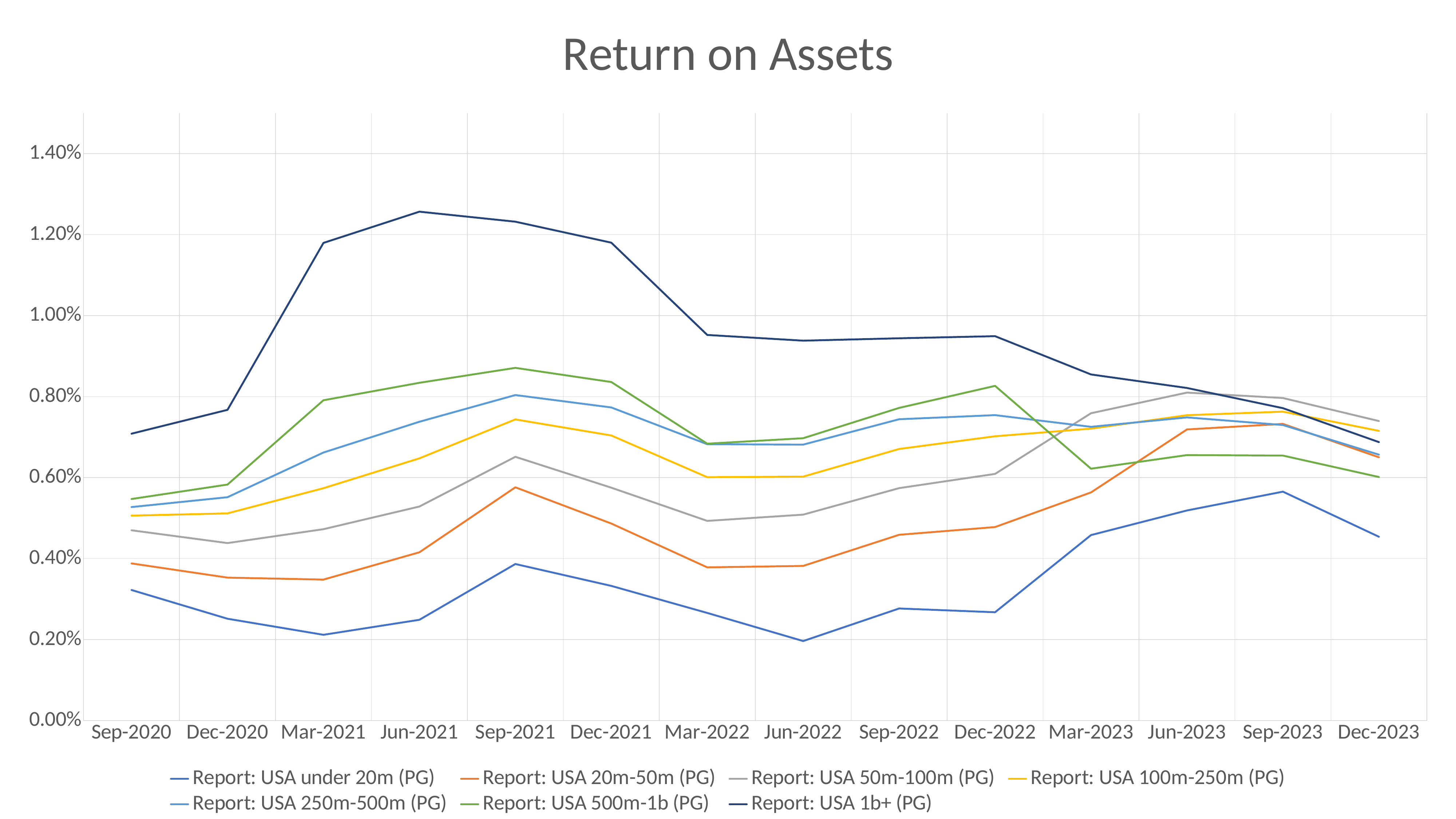
Is the value for Report: USA 50m-100m (PG) at Sep-2020 greater or less than 0.60%? less Is the value for Report: USA under 20m (PG) at Jun-2022 greater or less than 0.40%? less Which series has the highest value at Jun-2021? Report: USA 1b+ (PG) Which series has the highest value at Sep-2020? Report: USA 1b+ (PG) Which series has the lowest value at Jun-2022? Report: USA under 20m (PG) At Sep-2021, which is larger: Report: USA 500m-1b (PG) or Report: USA 20m-50m (PG)? Report: USA 500m-1b (PG) What is the title of the chart? Return on Assets What type of chart is shown on the slide? line chart How many series does the legend list? 7 Does the Report: USA 1b+ (PG) series rise or fall from Jun-2021 to Mar-2022? fall How many time points are shown on the x axis? 14 Is the value for Report: USA 1b+ (PG) at Jun-2021 greater or less than 1.20%? greater